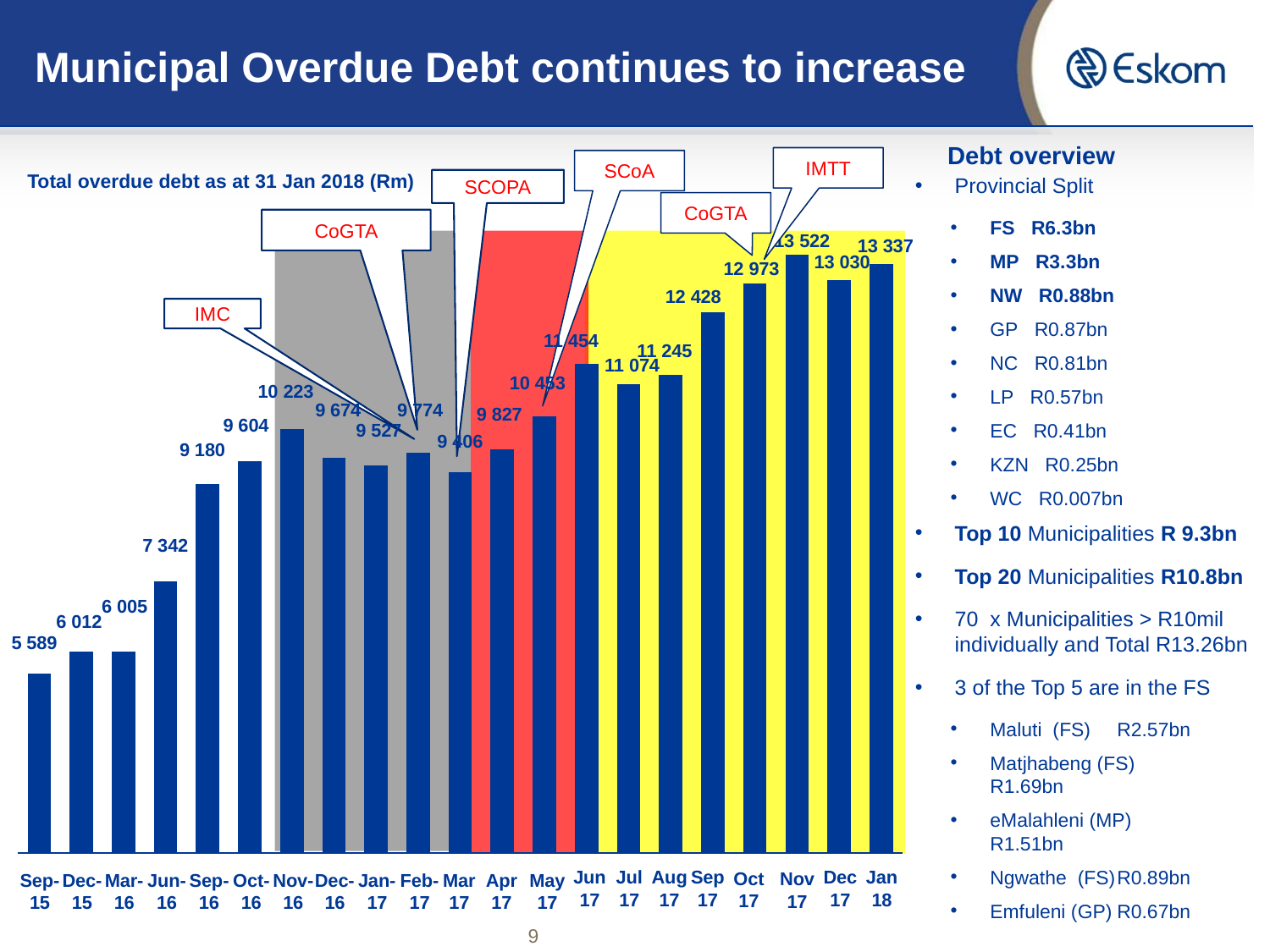
Which is larger, the value for Oct-16 or the value for Nov-16? Nov-16 What is the difference between the Oct 17 value and the Sep 17 value? 545 What is the value shown for Dec 17? 13 030 What is the title of the chart? Total overdue debt as at 31 Jan 2018 (Rm) What type of chart is shown on the slide? bar chart What is the total overdue debt value for Jan 18? 13 337 What is the value shown for Sep 17? 12 428 What is the difference between the Jan 18 value and the Sep-15 value? 7 748 Which month has the lowest total overdue debt? Sep-15 What is the value shown for Jun-16? 7 342 What is the total overdue debt value for Sep-15? 5 589 How many bars (months) are plotted in the chart? 21